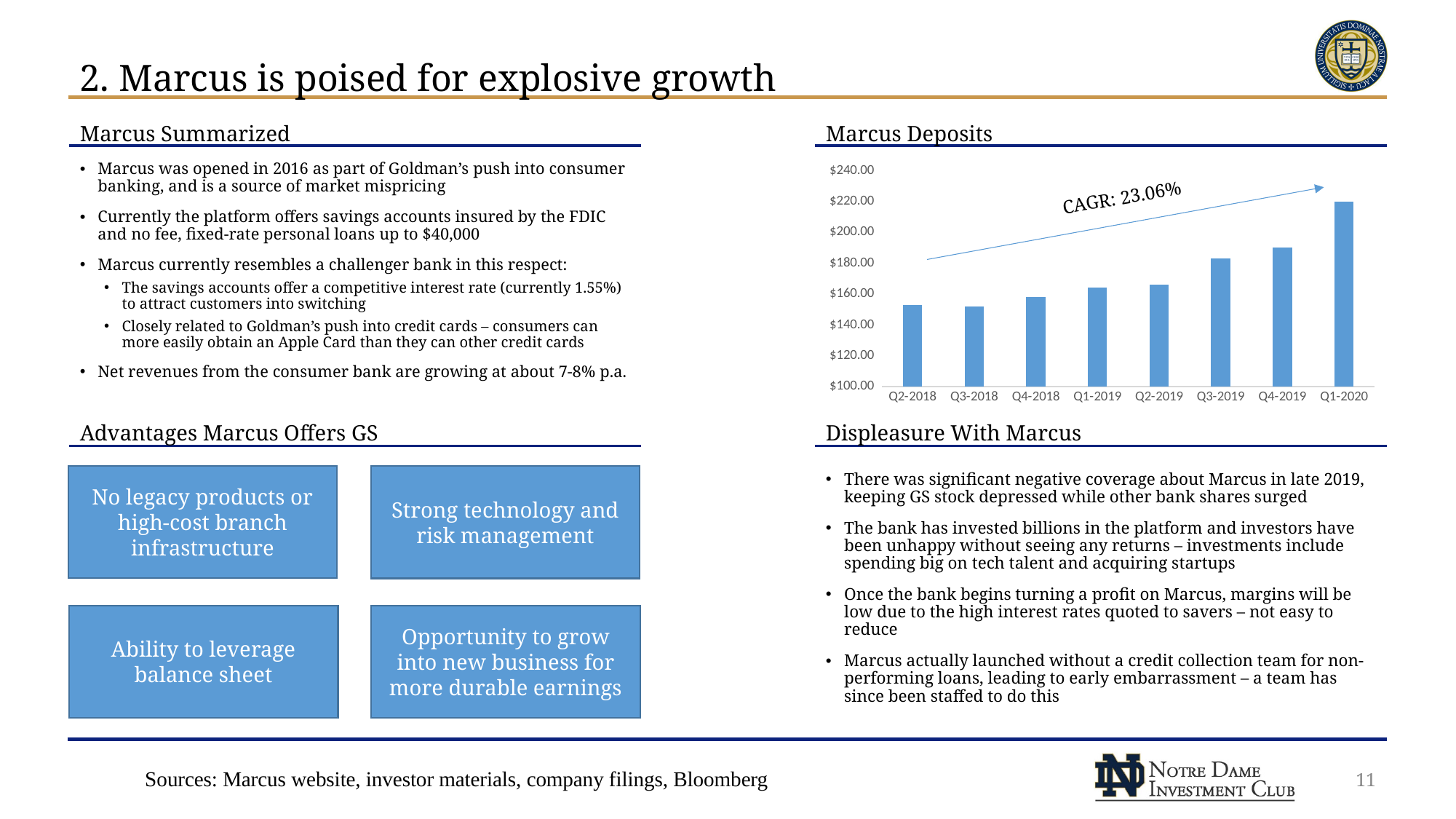
What is the first quarter shown on the x axis of the Marcus Deposits chart? Q2-2018 On the Marcus Deposits chart, is the value for Q2-2018 greater or less than $160.00? less On the Marcus Deposits chart, which is larger, the value for Q3-2019 or Q2-2019? Q3-2019 How many quarters are plotted on the Marcus Deposits chart? 8 Which quarter has the highest deposits on the Marcus Deposits chart? Q1-2020 What kind of chart is the Marcus Deposits chart? bar chart On the Marcus Deposits chart, is the value for Q4-2019 greater or less than $200.00? less What CAGR is annotated on the Marcus Deposits chart? 23.06% On the Marcus Deposits chart, is the value for Q1-2020 greater or less than $200.00? greater Do deposits on the Marcus Deposits chart generally rise or fall from Q2-2018 to Q1-2020? rise On the Marcus Deposits chart, which is larger, the value for Q1-2020 or Q4-2019? Q1-2020